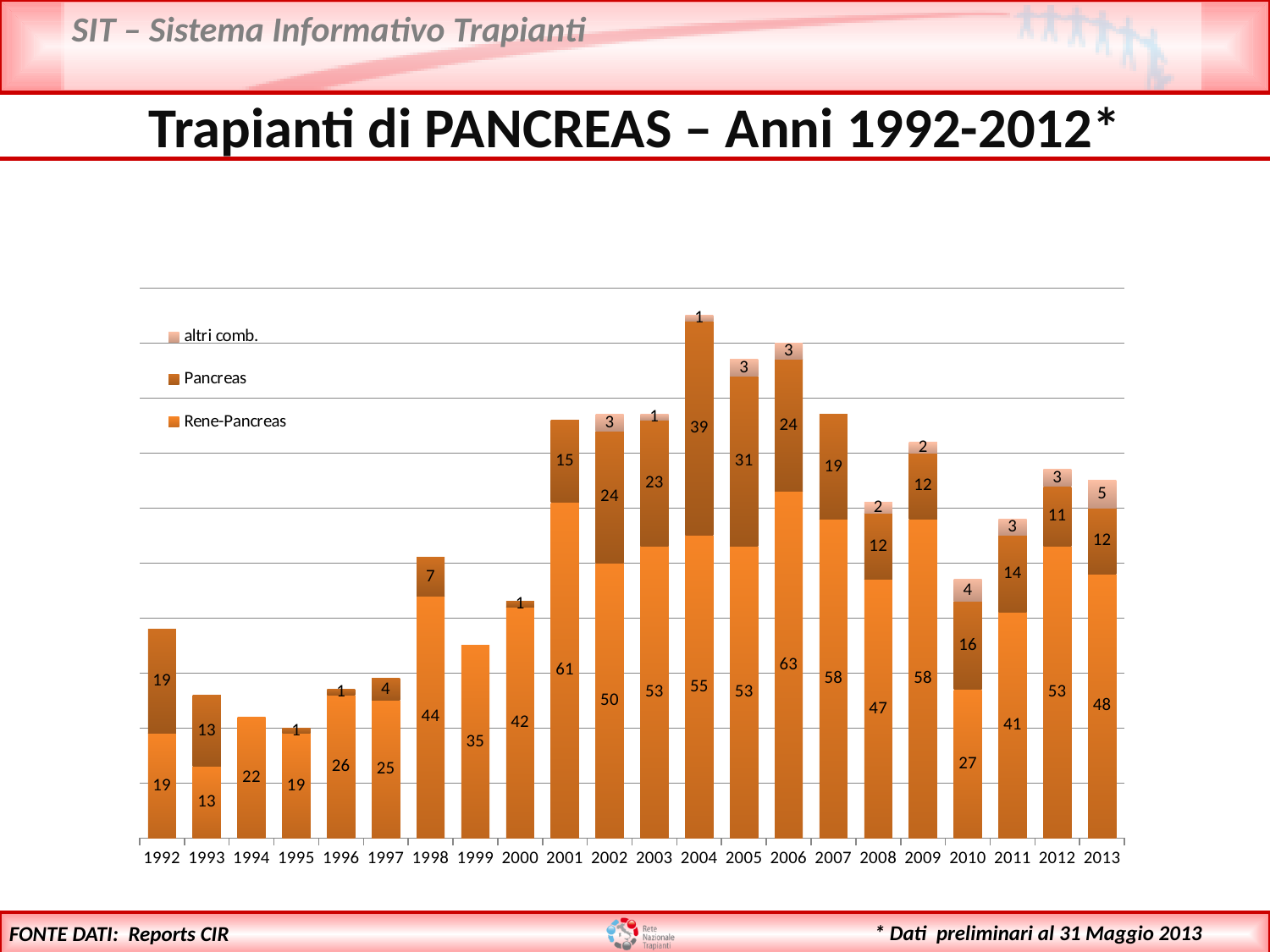
What is the altri comb. value for 2013? 5 How many series does the legend list? 3 Which year has the lowest Rene-Pancreas value? 1993 What are the three series named in the legend? altri comb., Pancreas, Rene-Pancreas What is the difference between the Rene-Pancreas values for 2001 and 2010? 34 What kind of chart is shown on the slide? Stacked bar chart What is the total of the stacked bar for 2004? 95 How many years are shown on the x axis? 22 Which year has the highest Rene-Pancreas value? 2006 Which year has the larger Pancreas value, 2002 or 2005? 2005 What is the Pancreas value for 2004? 39 What is the Rene-Pancreas value for 2006? 63